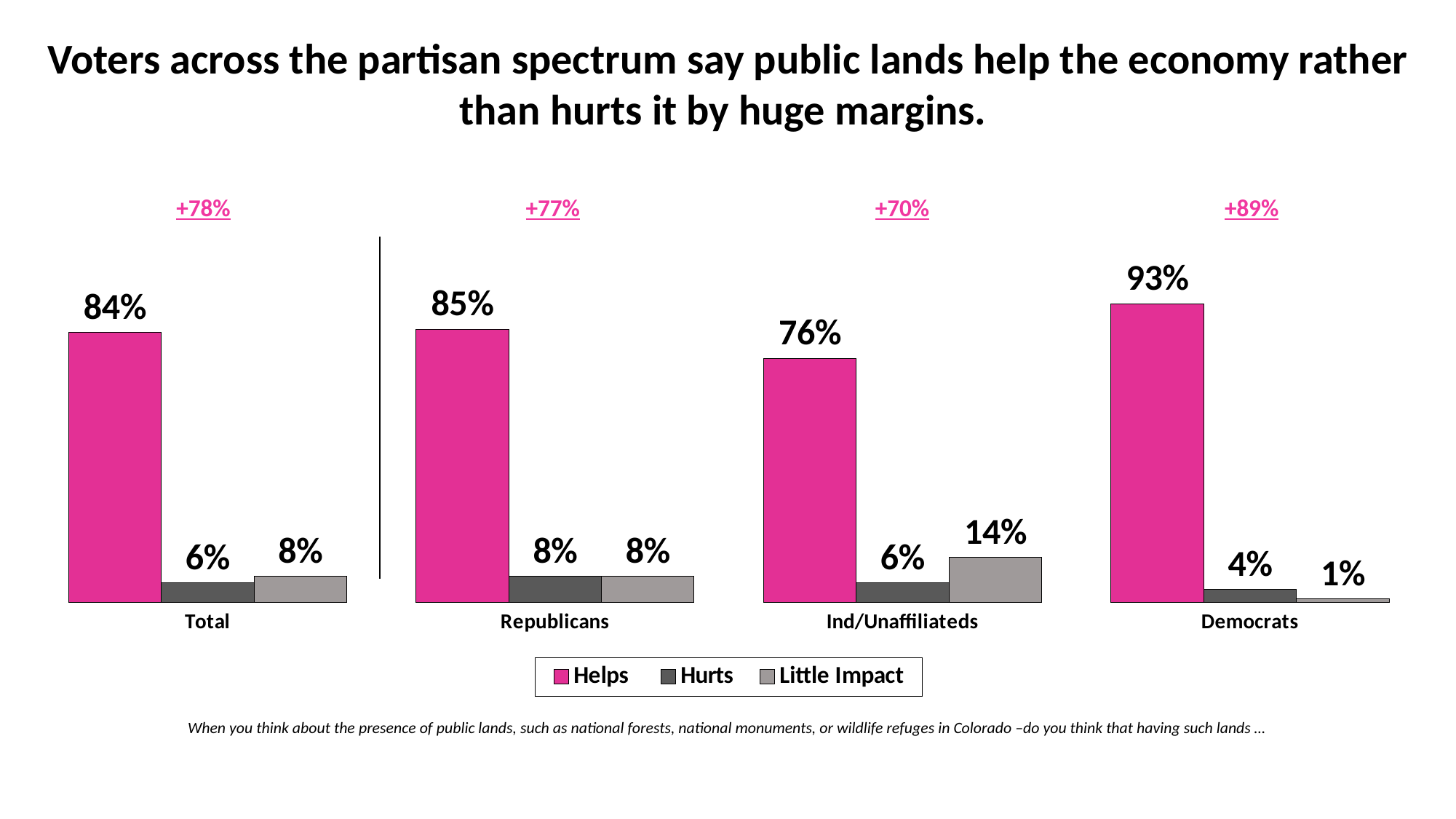
How many series does the legend list? 3 Which is larger for Ind/Unaffiliateds: the Hurts share or the Little Impact share? Little Impact How many groups are shown on the x axis? 4 Which group has the highest share saying public lands help the economy? Democrats What kind of chart is shown on the slide? Bar chart Which group has the lowest share saying public lands help the economy? Ind/Unaffiliateds What is the difference between the Helps and Hurts percentages for the Total group? 78% What percentage of Republicans say public lands hurt the economy? 8% What percentage of Ind/Unaffiliateds say public lands have little impact on the economy? 14% What percentage of Democrats say public lands help the economy? 93% Which series is shown in pink? Helps What is the net margin shown above the Democrats group? +89%